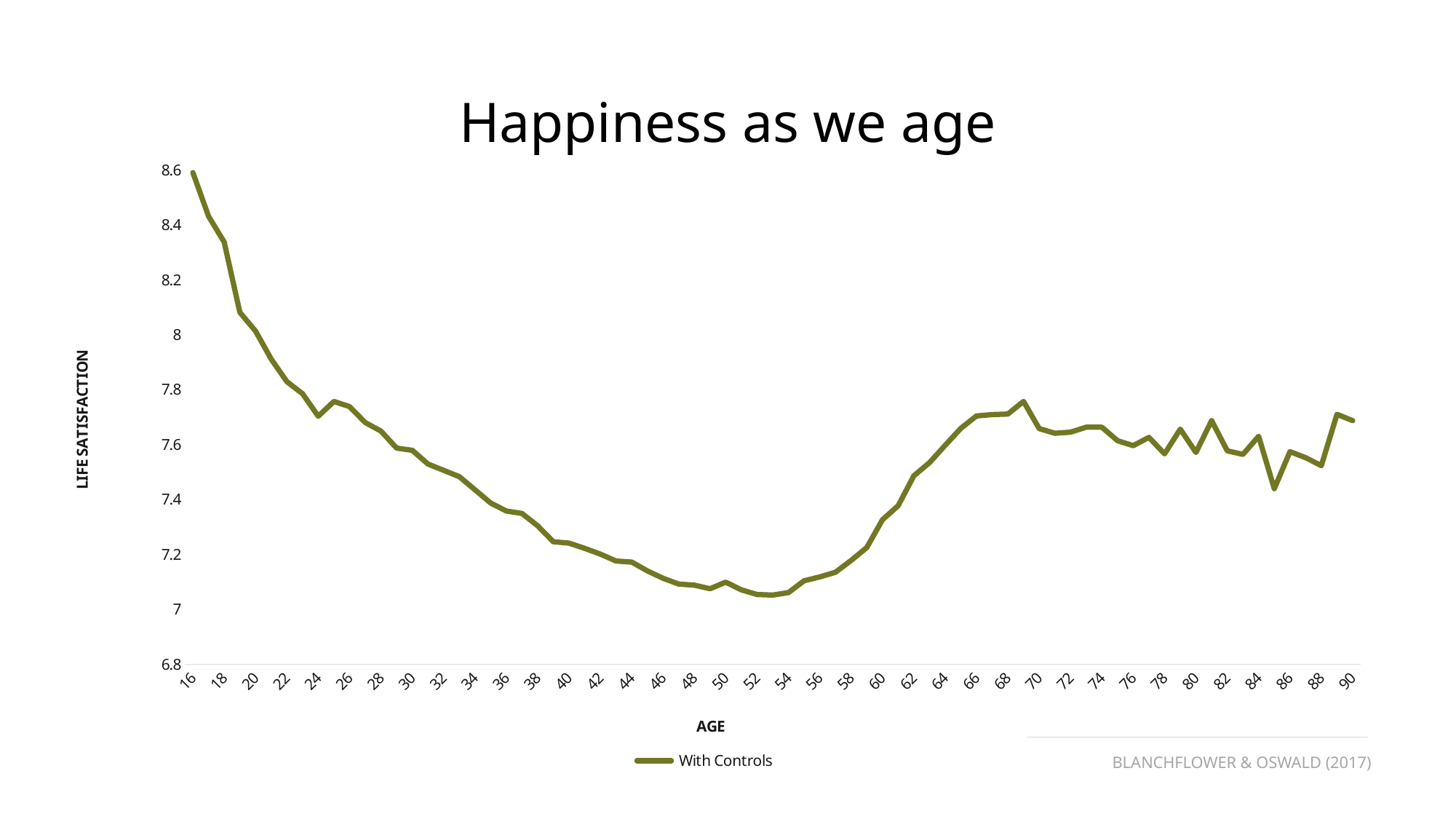
What is the title of the chart? Happiness as we age Is the value for age 85 greater or less than 7.6? less What kind of chart is shown on the slide? line chart Is the value for age 50 greater or less than 7.2? less Is the value for age 16 greater or less than 8.4? greater What is the name of the series shown in the legend? With Controls Which has the higher life satisfaction, age 40 or age 70? age 70 How many series does the legend list? 1 Which has the higher life satisfaction, age 24 or age 52? age 24 At which age is life satisfaction highest? 16 Does life satisfaction rise or fall between age 16 and age 52? fall